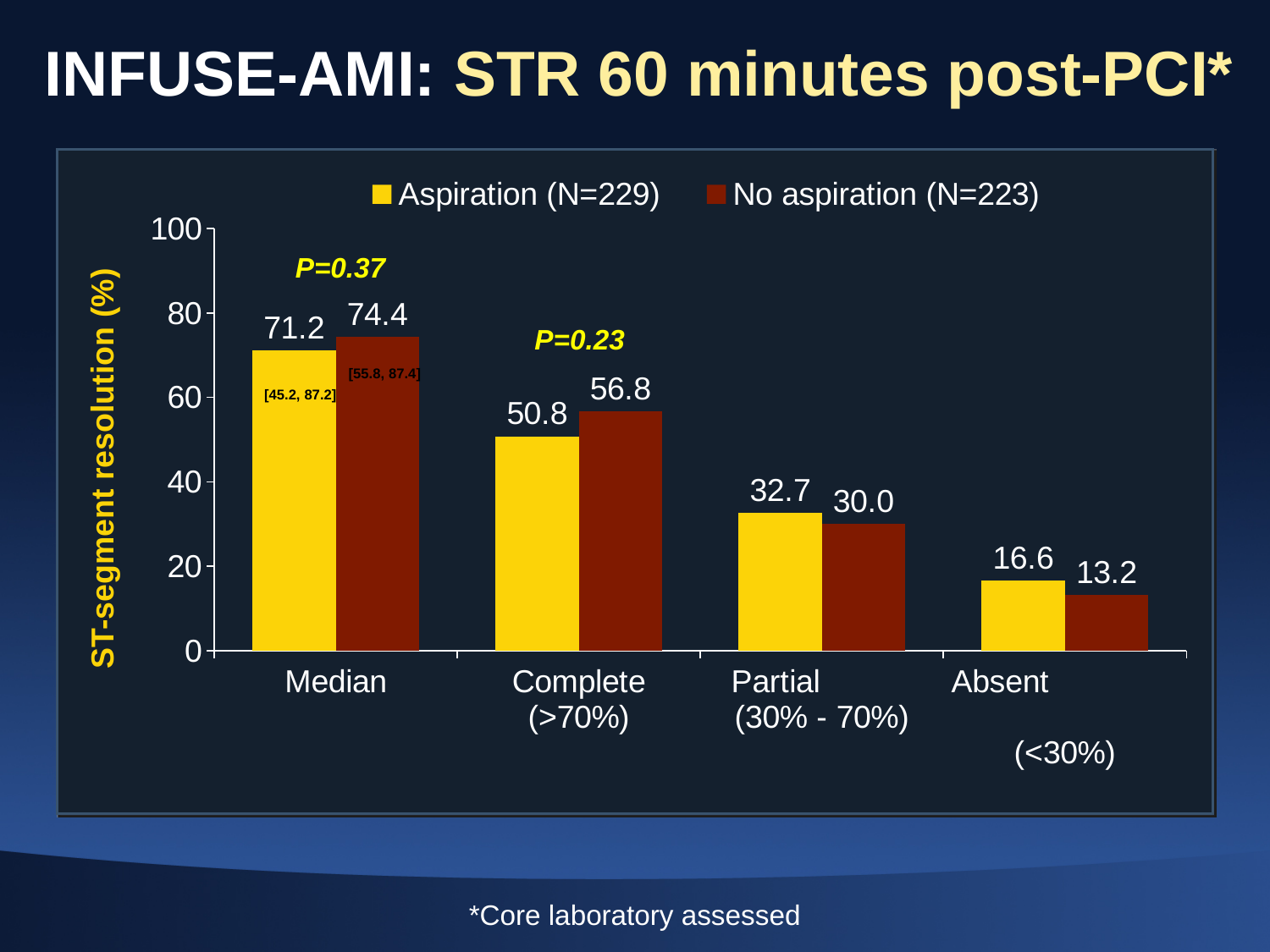
What kind of chart is shown on the slide? Bar chart What is the value for Aspiration in the Median category? 71.2 What is the value for No aspiration in the Complete (>70%) category? 56.8 Which category has the lowest value for Aspiration? Absent (<30%) How many series does the legend list? 2 Which category has the highest value for No aspiration? Median Is the value for No aspiration in the Absent (<30%) category greater or less than 20? less What is the P value shown above the Complete (>70%) bars? P=0.23 In the Partial (30% - 70%) category, which series has the larger value, Aspiration or No aspiration? Aspiration How many categories are shown on the x axis? 4 What is the difference between the No aspiration and Aspiration values in the Complete (>70%) category? 6.0 What is the value for Aspiration in the Absent (<30%) category? 16.6